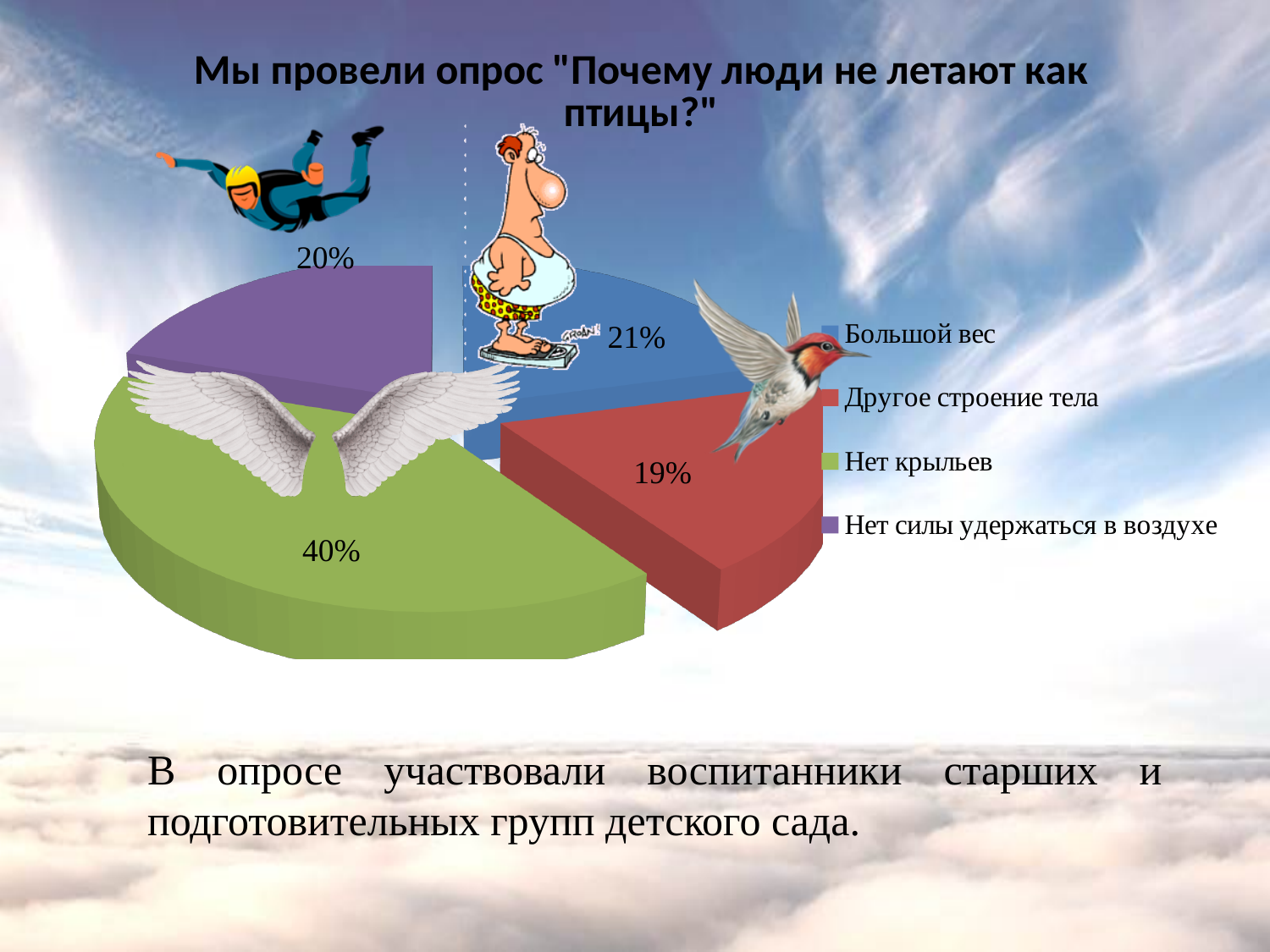
What type of chart is shown on the slide? Pie chart How many categories does the pie chart have? 4 What is the difference in percentage points between "Нет крыльев" and "Большой вес"? 19 What percentage of respondents answered "Нет крыльев"? 40% Which answer has the largest share of the pie? Нет крыльев Which answer has the smallest share of the pie? Другое строение тела What percentage of respondents answered "Другое строение тела"? 19% What colour is the slice for "Нет крыльев"? Green What is the title of the chart on the slide? Мы провели опрос "Почему люди не летают как птицы?" What percentage of respondents answered "Нет силы удержаться в воздухе"? 20% Which is larger: the share for "Нет крыльев" or the share for "Нет силы удержаться в воздухе"? Нет крыльев What percentage of respondents answered "Большой вес"? 21%